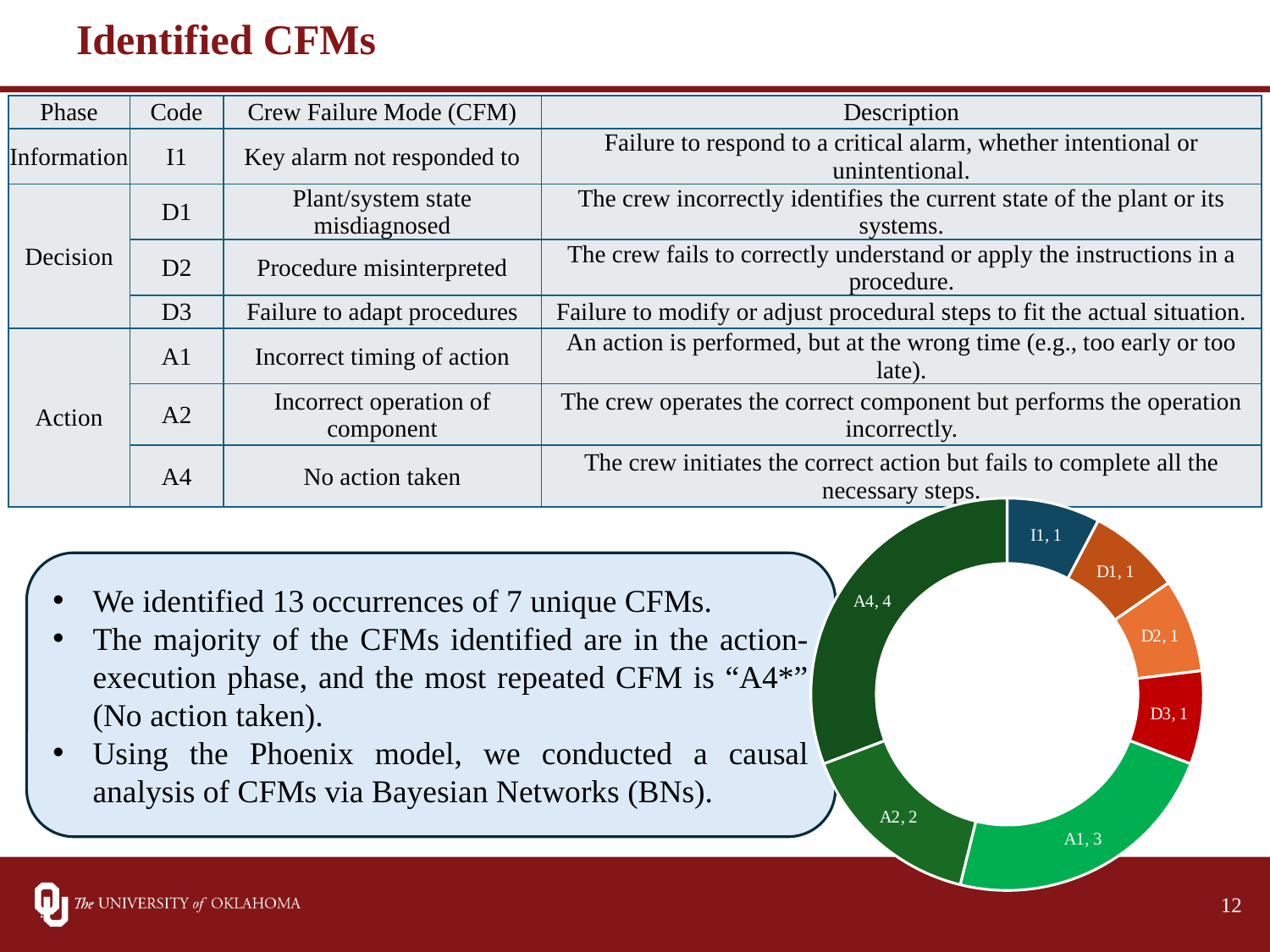
What is the value for D3 in the doughnut chart? 1 Which category has the largest value in the doughnut chart? A4 Which is larger in the doughnut chart, A1 or A2? A1 What is the value for A1 in the doughnut chart? 3 What is the difference between the values for A4 and A1 in the doughnut chart? 1 What kind of chart is shown on the slide? doughnut chart What share of the doughnut chart does A4 represent? 4/13 What is the total of all values shown in the doughnut chart? 13 How many categories in the doughnut chart have a value of 1? 4 What is the value for A4 in the doughnut chart? 4 What is the value for A2 in the doughnut chart? 2 How many categories does the doughnut chart show? 7